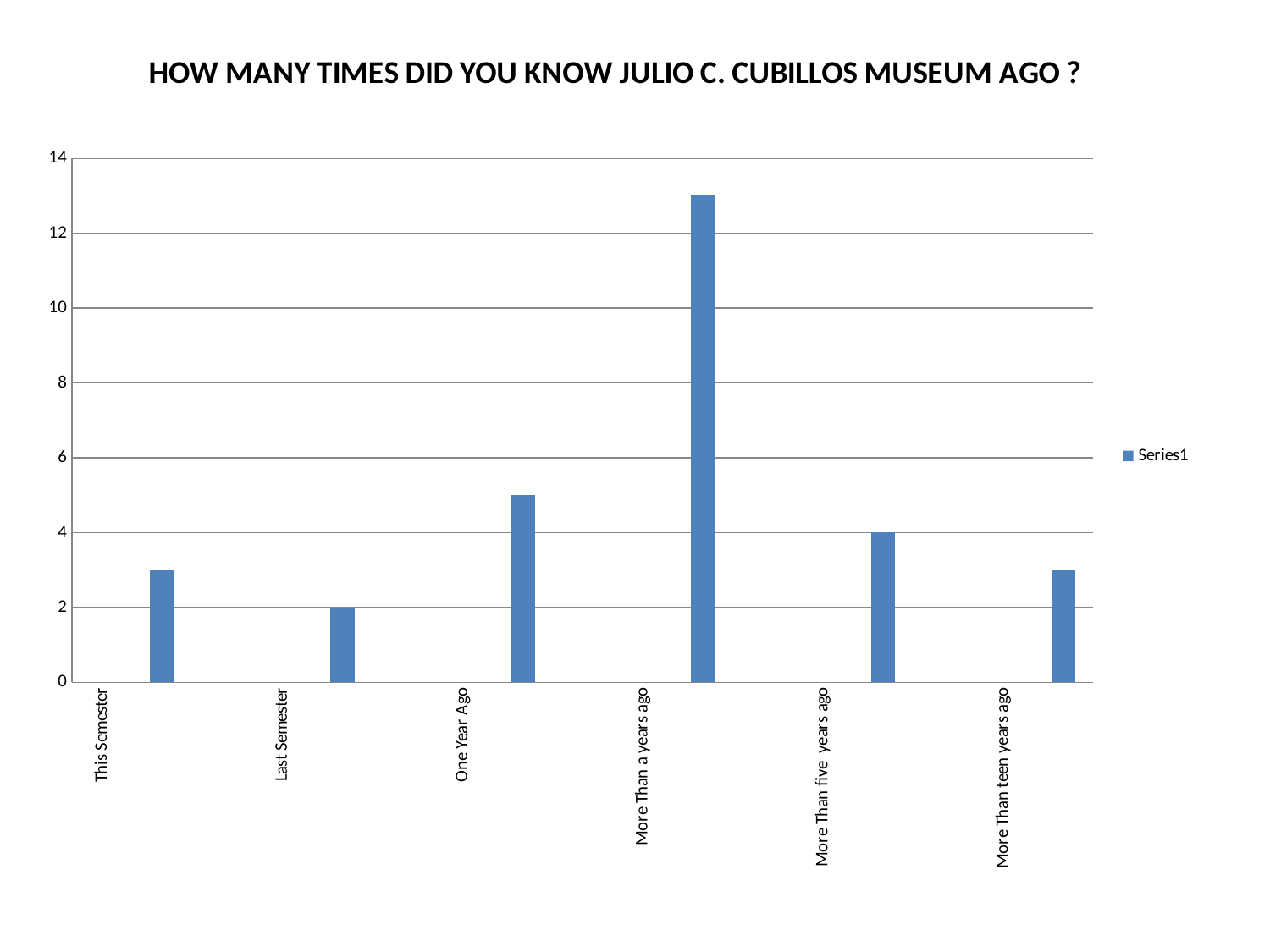
How many categories are shown on the x axis? 6 What is the value for Last Semester? 2 Is the value for More Than teen years ago greater or less than 4? less Is the value for More Than a years ago greater or less than 12? greater Which category has the highest value? More Than a years ago Which is larger, the value for One Year Ago or the value for This Semester? One Year Ago What is the value for More Than five years ago? 4 Is the value for This Semester greater or less than 2? greater How many series does the legend list? 1 Which category has the lowest value? Last Semester What is the difference between the values for More Than five years ago and Last Semester? 2 What kind of chart is shown on the slide? bar chart